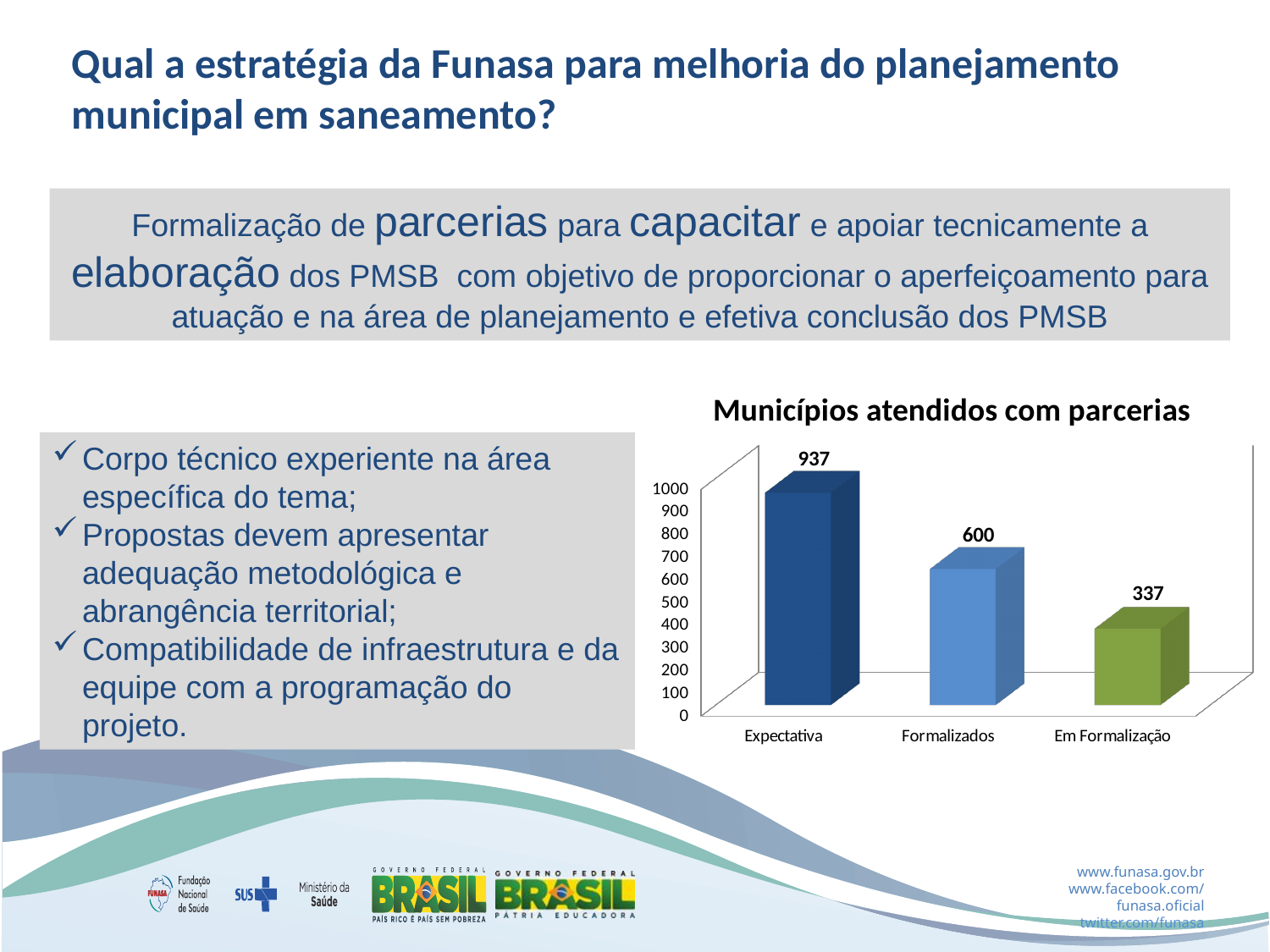
How many categories are shown in the chart? 3 Which is larger, the value for Formalizados or the value for Em Formalização? Formalizados What kind of chart is shown on the slide? bar chart What is the value for Formalizados? 600 Which category has the highest value? Expectativa Which category has the lowest value? Em Formalização What is the title of the chart? Municípios atendidos com parcerias What is the difference between the values for Expectativa and Formalizados? 337 What is the difference between the values for Formalizados and Em Formalização? 263 Is the value for Em Formalização greater or less than 400? less What is the value for Em Formalização? 337 What is the value for Expectativa? 937